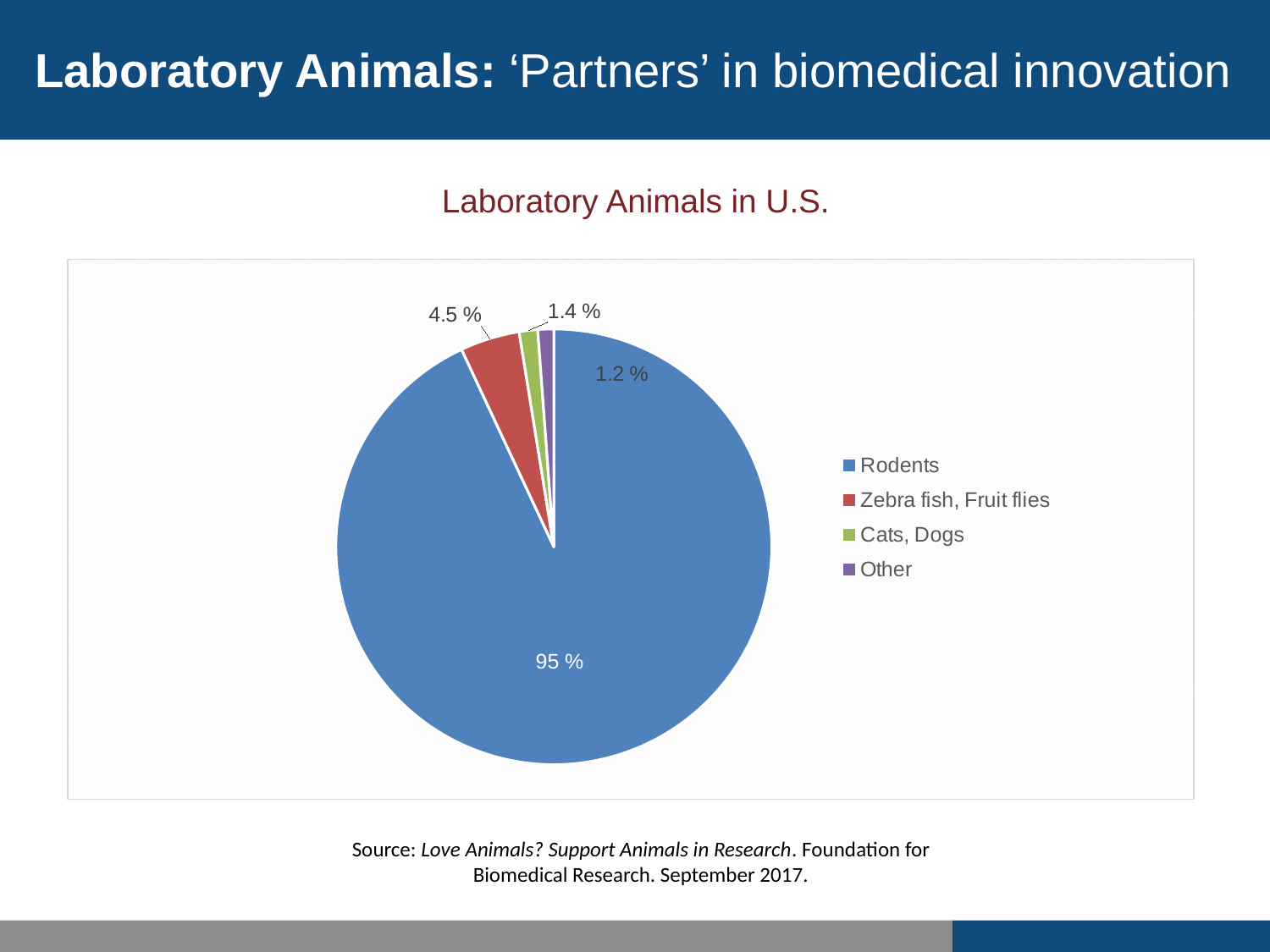
What is the title of the chart? Laboratory Animals in U.S. What percentage of the pie is Other? 1.2 % Which is larger, the share for Zebra fish, Fruit flies or the share for Cats, Dogs? Zebra fish, Fruit flies Which category has the largest share of the pie? Rodents What percentage of the pie is Zebra fish, Fruit flies? 4.5 % What type of chart is shown on the slide? pie chart What percentage of the pie is Cats, Dogs? 1.4 % What is the difference between the Rodents share and the Zebra fish, Fruit flies share? 90.5 % What percentage of laboratory animals in the U.S. are Rodents? 95 % What colour is the Rodents slice? blue Which category has the smallest share of the pie? Other How many categories does the legend list? 4